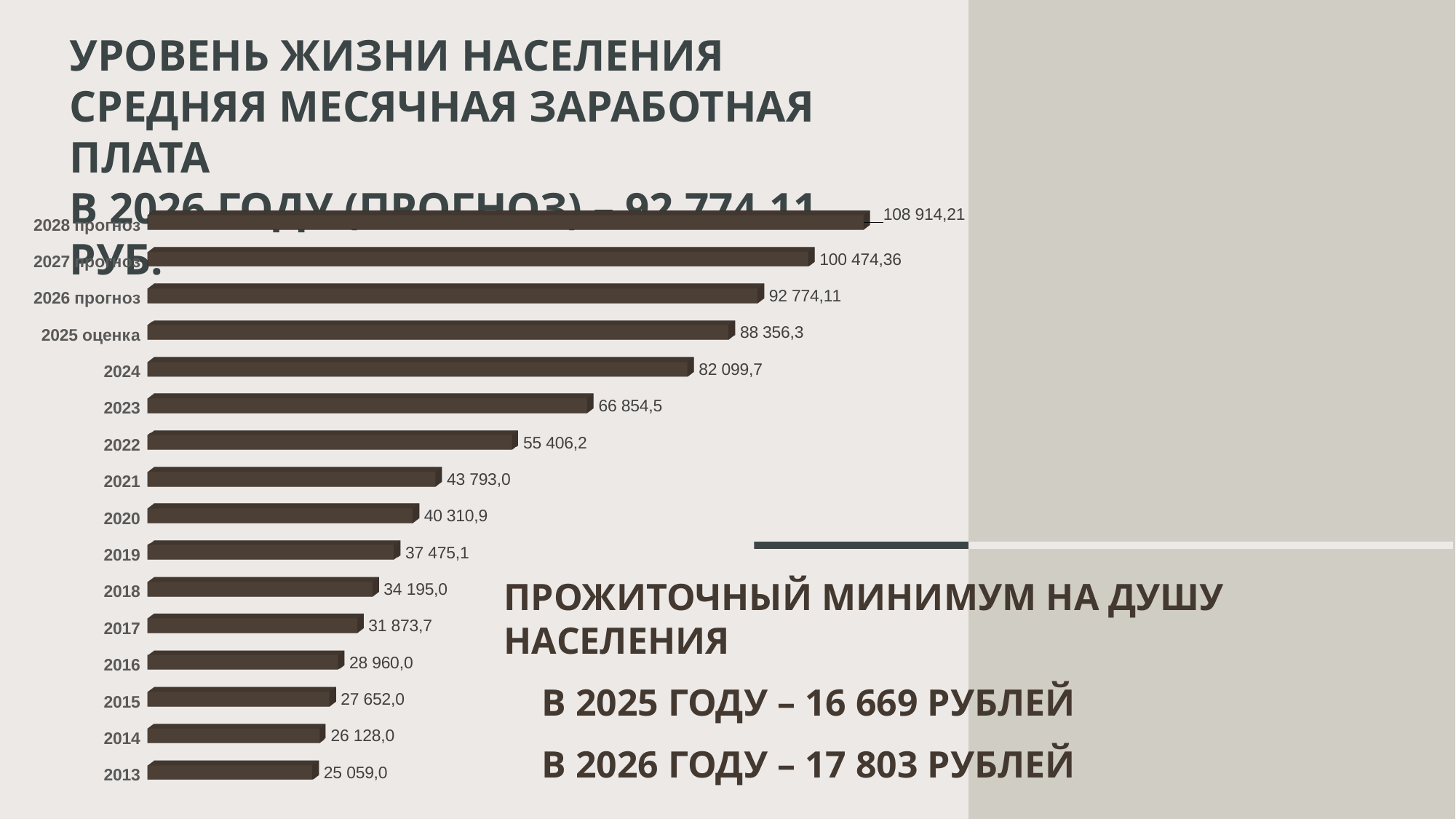
What is the value shown for 2013 on the chart? 25 059,0 Which category has the lowest value on the chart? 2013 What is the value shown for 2025 оценка on the chart? 88 356,3 How many categories (bars) are shown on the chart? 16 What is the value shown for 2024 on the chart? 82 099,7 What is the value shown for 2028 прогноз on the chart? 108 914,21 What is the difference between the values for 2024 and 2023? 15 245,2 What kind of chart is shown on the slide? Bar chart Do the values rise or fall from 2013 to 2028 прогноз? Rise Which category has the highest value on the chart? 2028 прогноз Which is larger, the value for 2022 or the value for 2021? 2022 What is the difference between the values for 2014 and 2013? 1 069,0